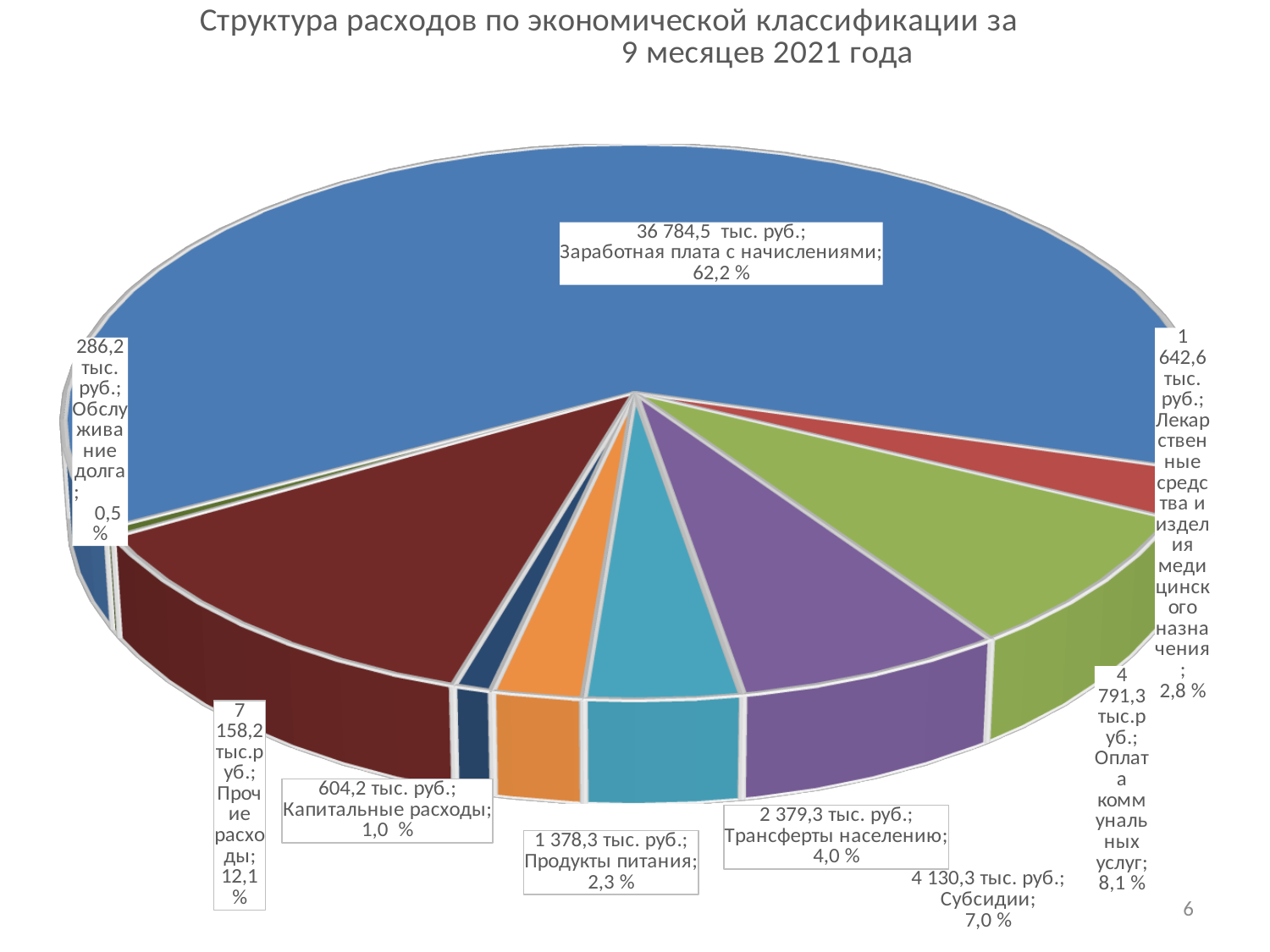
What is the value for Капитальные расходы? 604,2 тыс. руб. What is the value for Заработная плата с начислениями? 36 784,5 тыс. руб. What is the title of the chart? Структура расходов по экономической классификации за 9 месяцев 2021 года How many slices does the pie chart have? 9 What share of the pie does Заработная плата с начислениями take? 62,2 % Which category has the smallest slice? Обслуживание долга Which is larger, Субсидии or Трансферты населению? Субсидии What share of the pie does Прочие расходы take? 12,1 % Which category has the largest slice? Заработная плата с начислениями What is the value for Оплата коммунальных услуг? 4 791,3 тыс.руб. What is the difference in percentage share between Оплата коммунальных услуг and Субсидии? 1,1 % What kind of chart is shown on the slide? pie chart